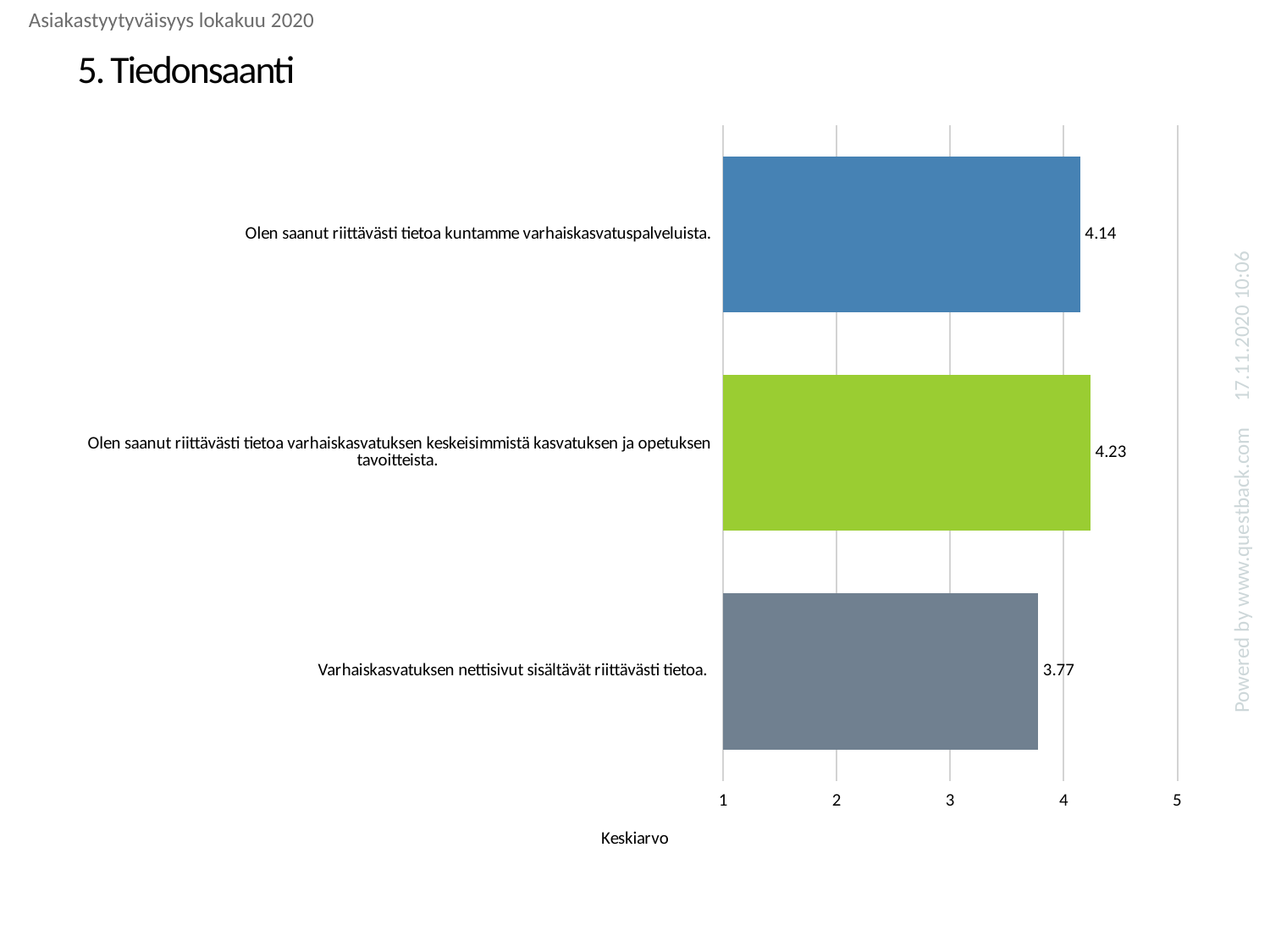
What is the label of the horizontal axis? Keskiarvo Is the value for "Varhaiskasvatuksen nettisivut sisältävät riittävästi tietoa." greater or less than 4? less What is the difference between the values for "Olen saanut riittävästi tietoa varhaiskasvatuksen keskeisimmistä kasvatuksen ja opetuksen tavoitteista." and "Varhaiskasvatuksen nettisivut sisältävät riittävästi tietoa."? 0.46 Which category has the lowest value? Varhaiskasvatuksen nettisivut sisältävät riittävästi tietoa. Which is larger: the value for "Olen saanut riittävästi tietoa kuntamme varhaiskasvatuspalveluista." or the value for "Varhaiskasvatuksen nettisivut sisältävät riittävästi tietoa."? Olen saanut riittävästi tietoa kuntamme varhaiskasvatuspalveluista. What is the difference between the values for "Olen saanut riittävästi tietoa varhaiskasvatuksen keskeisimmistä kasvatuksen ja opetuksen tavoitteista." and "Olen saanut riittävästi tietoa kuntamme varhaiskasvatuspalveluista."? 0.09 What kind of chart is shown on the slide? bar chart What is the value for "Olen saanut riittävästi tietoa varhaiskasvatuksen keskeisimmistä kasvatuksen ja opetuksen tavoitteista."? 4.23 Which category has the highest value? Olen saanut riittävästi tietoa varhaiskasvatuksen keskeisimmistä kasvatuksen ja opetuksen tavoitteista. What is the value for "Olen saanut riittävästi tietoa kuntamme varhaiskasvatuspalveluista."? 4.14 What is the value for "Varhaiskasvatuksen nettisivut sisältävät riittävästi tietoa."? 3.77 How many categories are shown in the chart? 3